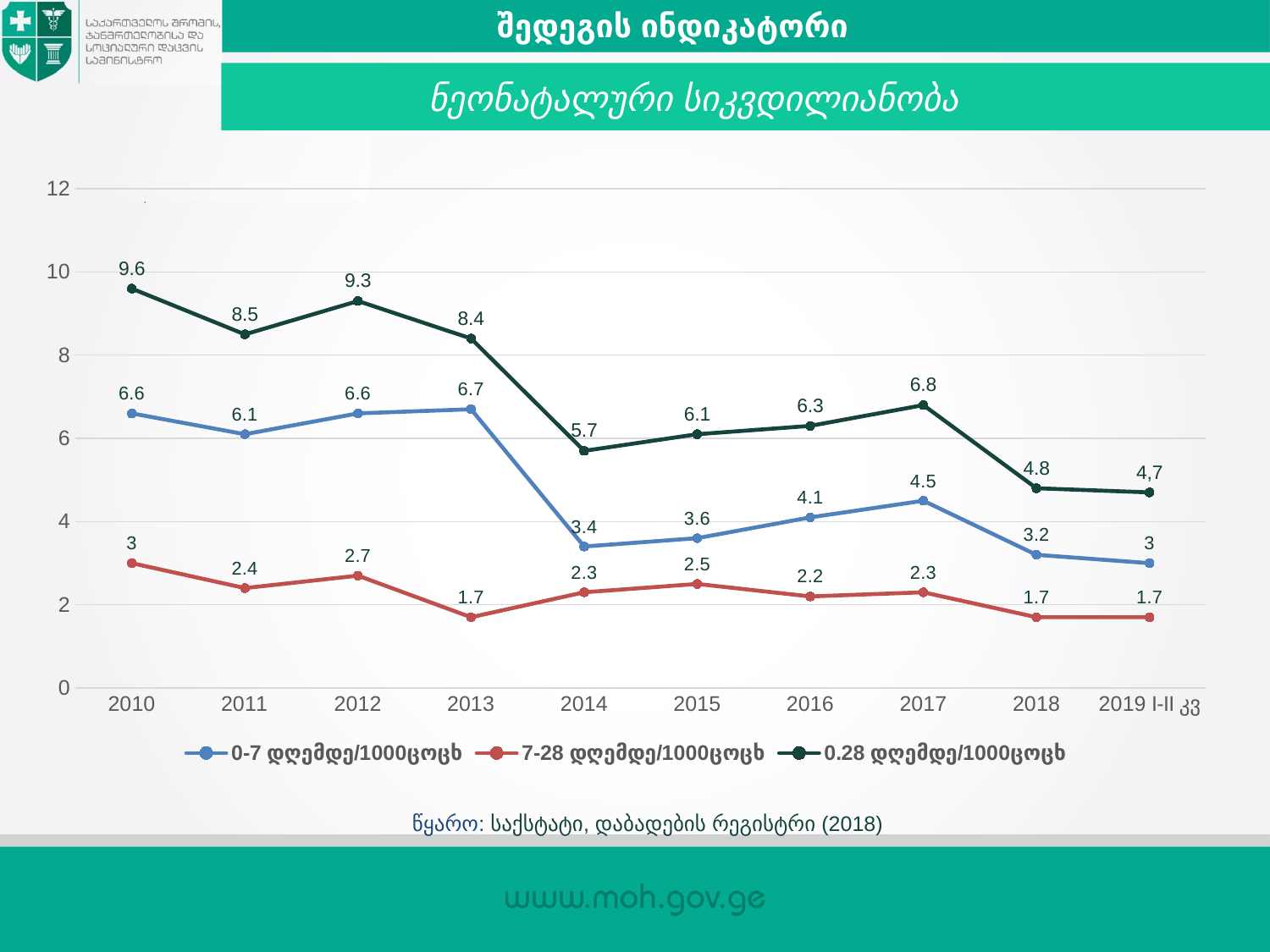
What is the value of the 7-28 დღემდე/1000ცოცხ series in 2015? 2.5 How many series does the legend list? 3 What is the value of the 0-7 დღემდე/1000ცოცხ series in 2014? 3.4 Does the 0.28 დღემდე/1000ცოცხ series generally rise or fall from 2010 to 2019 I-II კვ? fall In which year does the 0.28 დღემდე/1000ცოცხ series reach its highest value? 2010 What is the value of the 0.28 დღემდე/1000ცოცხ series in 2010? 9.6 What type of chart is shown on the slide? line chart In which year does the 0-7 დღემდე/1000ცოცხ series reach its lowest value? 2019 I-II კვ How many points along the x axis does each series have? 10 What is the title of the chart? ნეონატალური სიკვდილიანობა What is the difference between the 0.28 დღემდე/1000ცოცხ values in 2013 and 2014? 2.7 Which is larger in 2017: the 0-7 დღემდე/1000ცოცხ value or the 7-28 დღემდე/1000ცოცხ value? 0-7 დღემდე/1000ცოცხ